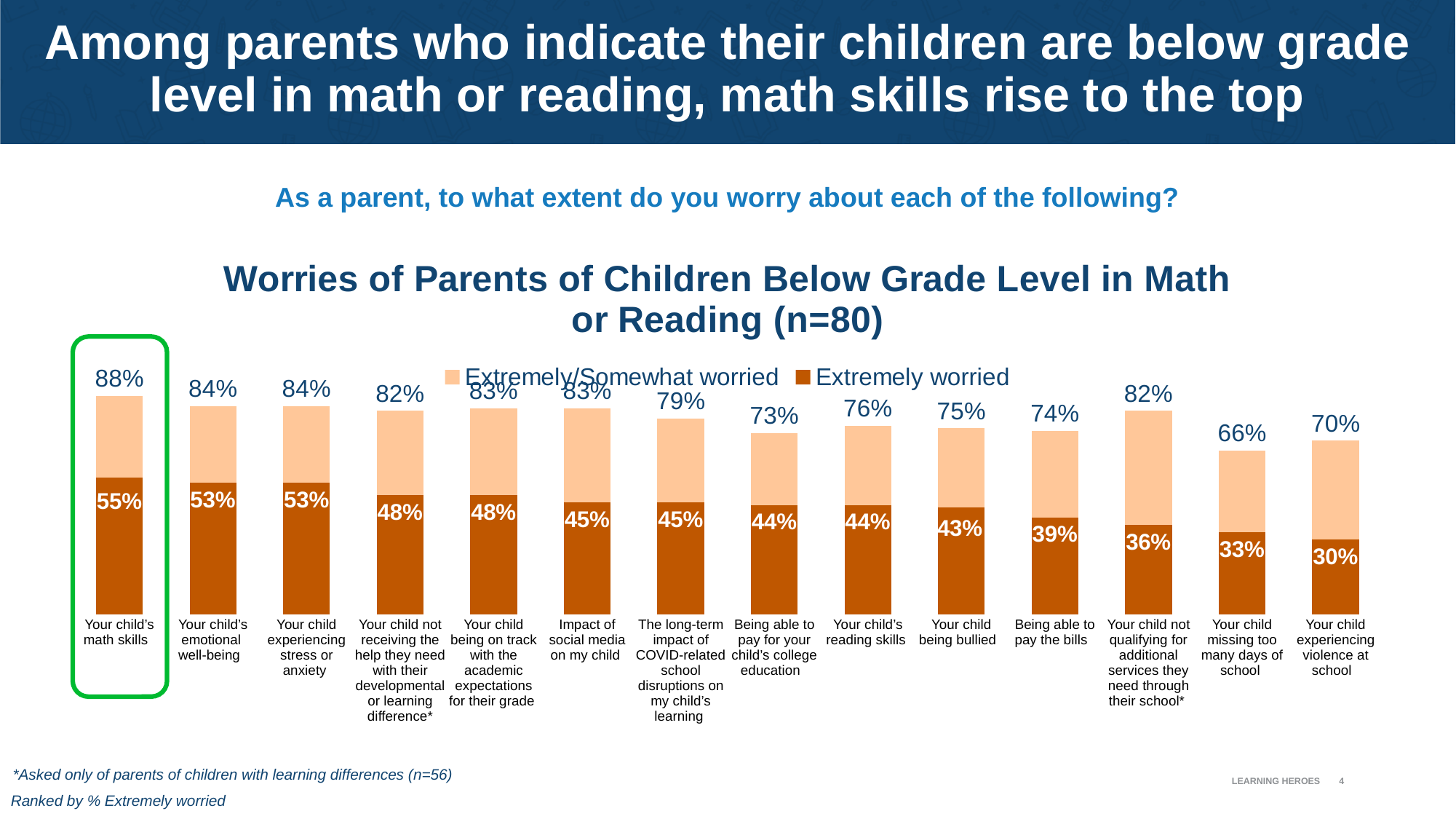
Which has a higher Extremely worried percentage: 'Being able to pay the bills' or 'Your child being bullied'? Your child being bullied What is the title of the chart? Worries of Parents of Children Below Grade Level in Math or Reading (n=80) Which category has the highest Extremely worried percentage? Your child's math skills What is the Extremely/Somewhat worried percentage for 'Your child's reading skills'? 76% Which category has the lowest Extremely/Somewhat worried percentage? Your child missing too many days of school What kind of chart is shown on the slide? Stacked bar chart What percentage of parents are extremely worried about their child experiencing violence at school? 30% What is the difference between the Extremely worried percentages for 'Your child's math skills' and 'Your child's reading skills'? 11% What is the Extremely/Somewhat worried percentage for 'Your child not qualifying for additional services they need through their school*'? 82% What percentage of parents are extremely worried about their child's math skills? 55% How many series does the legend list? 2 How many worry categories are shown along the x axis? 14